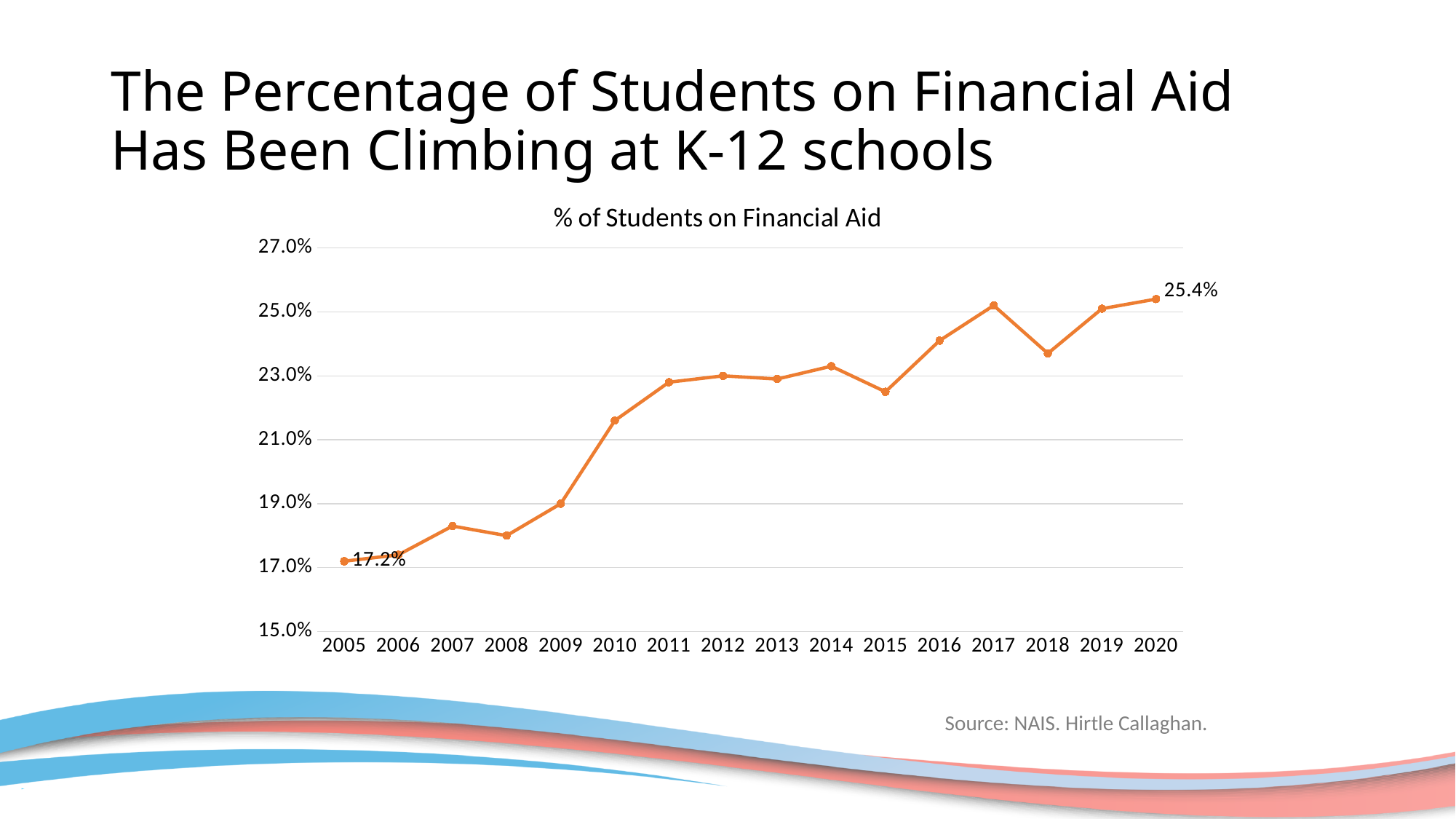
Is the value for 2008 greater or less than 19.0%? less Is the value for 2015 greater or less than 23.0%? less Is the value for 2018 greater or less than 23.0%? greater Which year has the higher value, 2009 or 2010? 2010 Do the values generally rise or fall from 2005 to 2020? Rise How many years are plotted on the chart? 16 What is the value for 2020? 25.4% Which year has the higher value, 2017 or 2018? 2017 What is the value for 2005? 17.2% By how much did the percentage of students on financial aid increase from 2005 to 2020? 8.2 percentage points What kind of chart is shown on the slide? Line chart